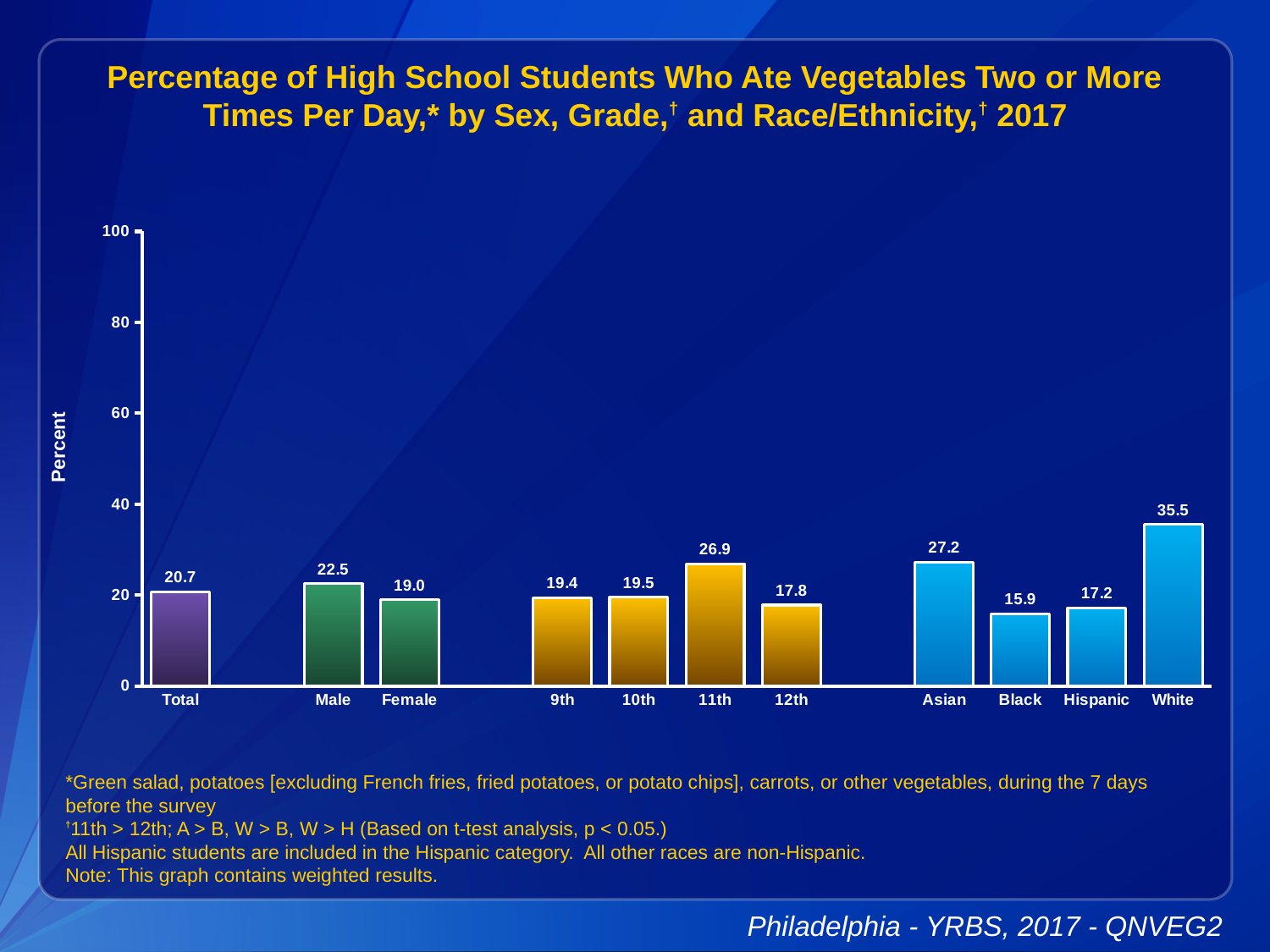
What is the value for Male? 22.5 How many bars are shown in the chart? 11 Is the value for Asian greater or less than 20? greater What is the value for 11th grade? 26.9 Which category has the lowest value? Black What is the value for Total? 20.7 What is the value for Hispanic students? 17.2 Which category has the highest value? White Which is larger, the value for 11th grade or 12th grade? 11th What is the difference between the values for White and Asian? 8.3 What is the difference between the values for Male and Female? 3.5 What kind of chart is shown on the slide? bar chart